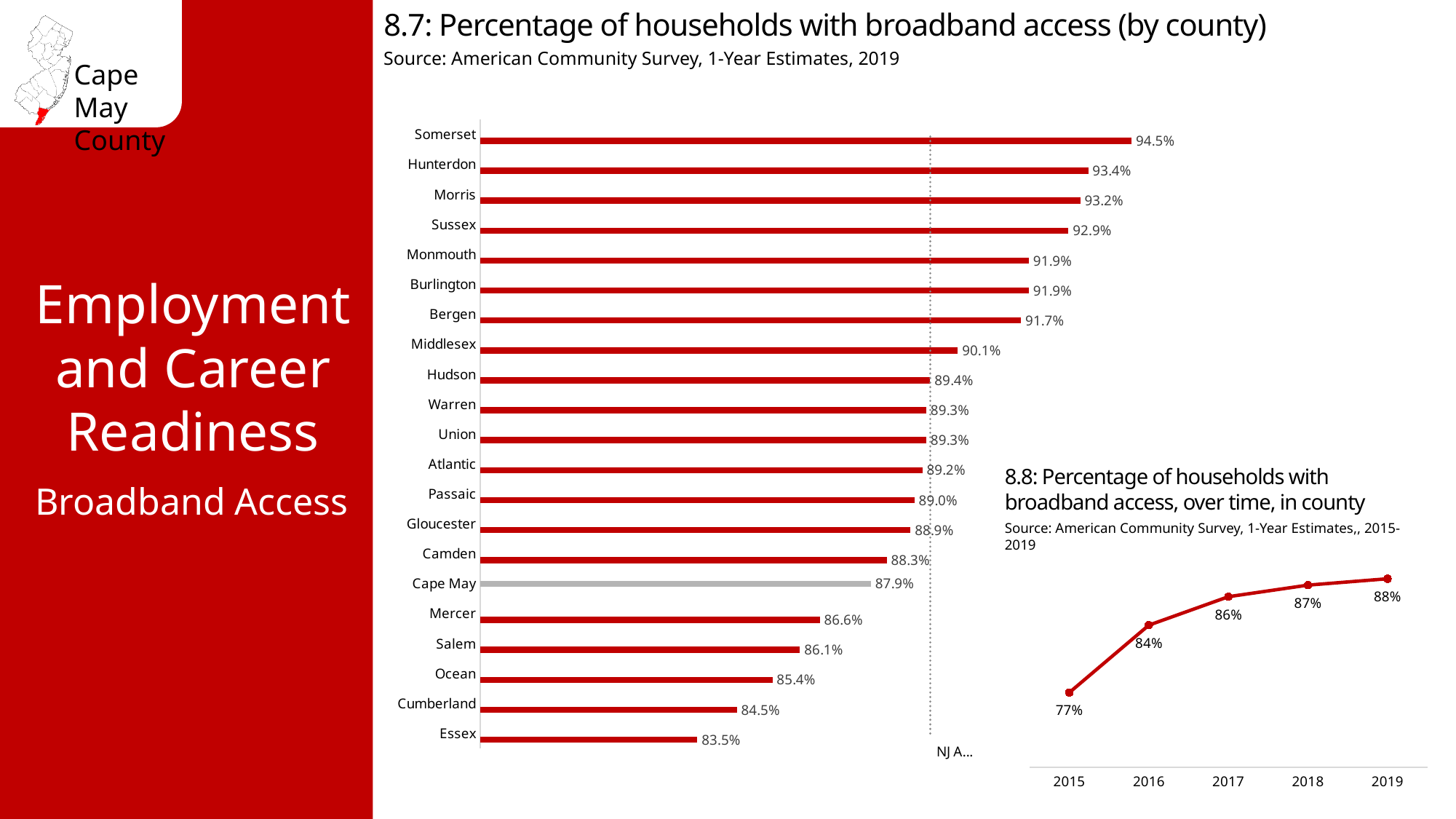
What kind of chart is chart 8.8 (percentage of households with broadband access over time in county)? Line chart In the chart 8.8 (broadband access over time in county), what is the value for 2015? 77% In the chart 8.7 (by county), how many counties are shown? 21 In the chart 8.7 (percentage of households with broadband access by county), what is the value for Cape May? 87.9% In the chart 8.7 (by county), which has a higher value, Mercer or Ocean? Mercer In the chart 8.8 (broadband access over time in county), what is the difference between the 2019 and 2015 values? 11% In the chart 8.7 (by county), what is the difference between the values for Somerset and Essex? 11.0% What kind of chart is chart 8.7 (percentage of households with broadband access by county)? Bar chart In the chart 8.7 (by county), which county has the lowest percentage of households with broadband access? Essex In the chart 8.8 (broadband access over time in county), do the values rise or fall from 2015 to 2019? Rise In the chart 8.7 (by county), what is the value for Hunterdon? 93.4% In the chart 8.7 (by county), which county has the highest percentage of households with broadband access? Somerset